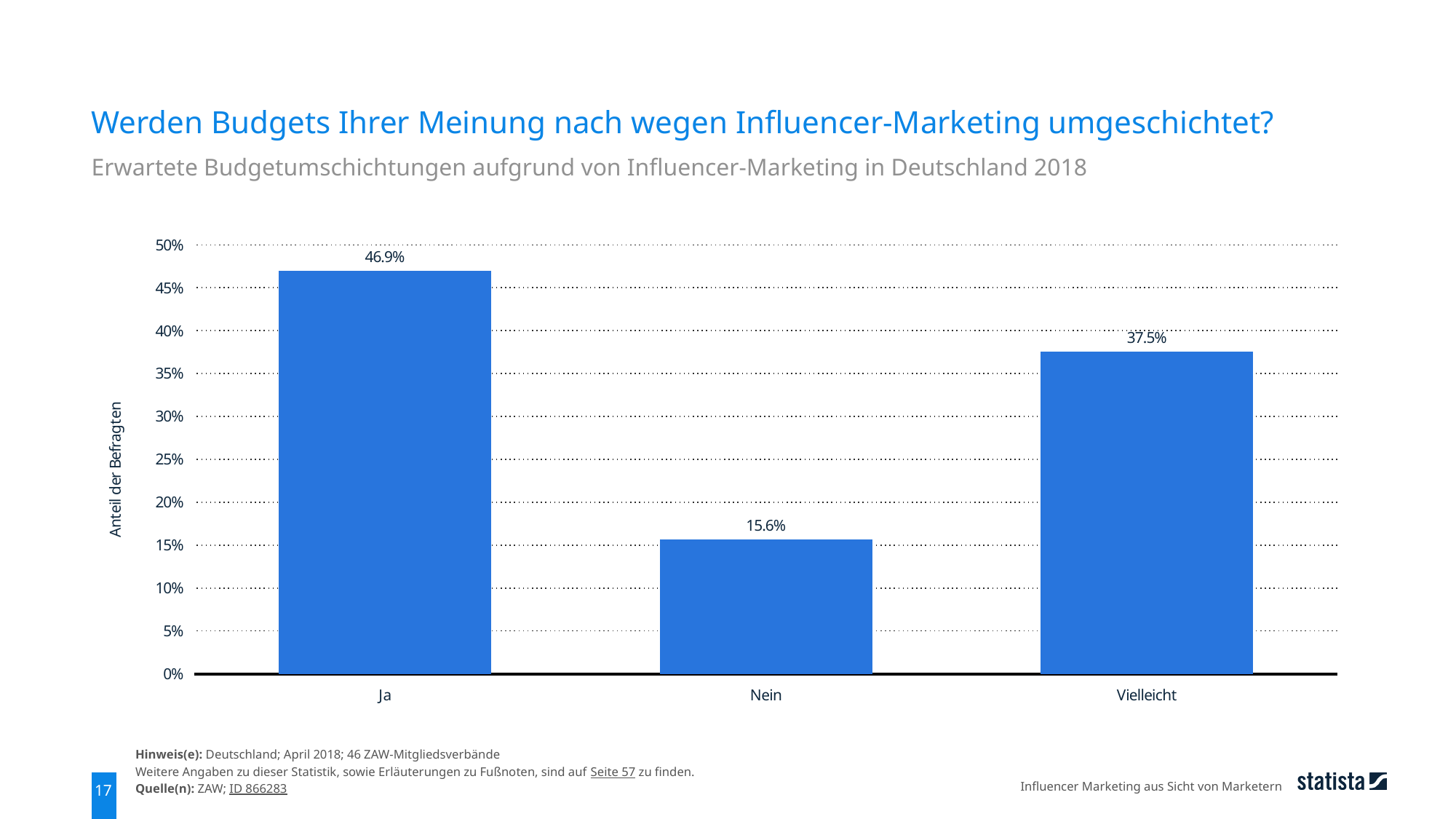
What kind of chart is shown on the slide? Bar chart Which answer category has the lowest share of respondents? Nein Is the value for "Vielleicht" greater or less than 40%? less Which answer category has the highest share of respondents? Ja What percentage of respondents answered "Vielleicht"? 37.5% What is the label of the vertical axis? Anteil der Befragten What is the difference in percentage points between "Vielleicht" and "Nein"? 21.9 percentage points Which is larger, the share for "Nein" or the share for "Vielleicht"? Vielleicht What is the difference in percentage points between "Ja" and "Vielleicht"? 9.4 percentage points How many answer categories are shown in the chart? 3 What percentage of respondents answered "Ja"? 46.9% What percentage of respondents answered "Nein"? 15.6%